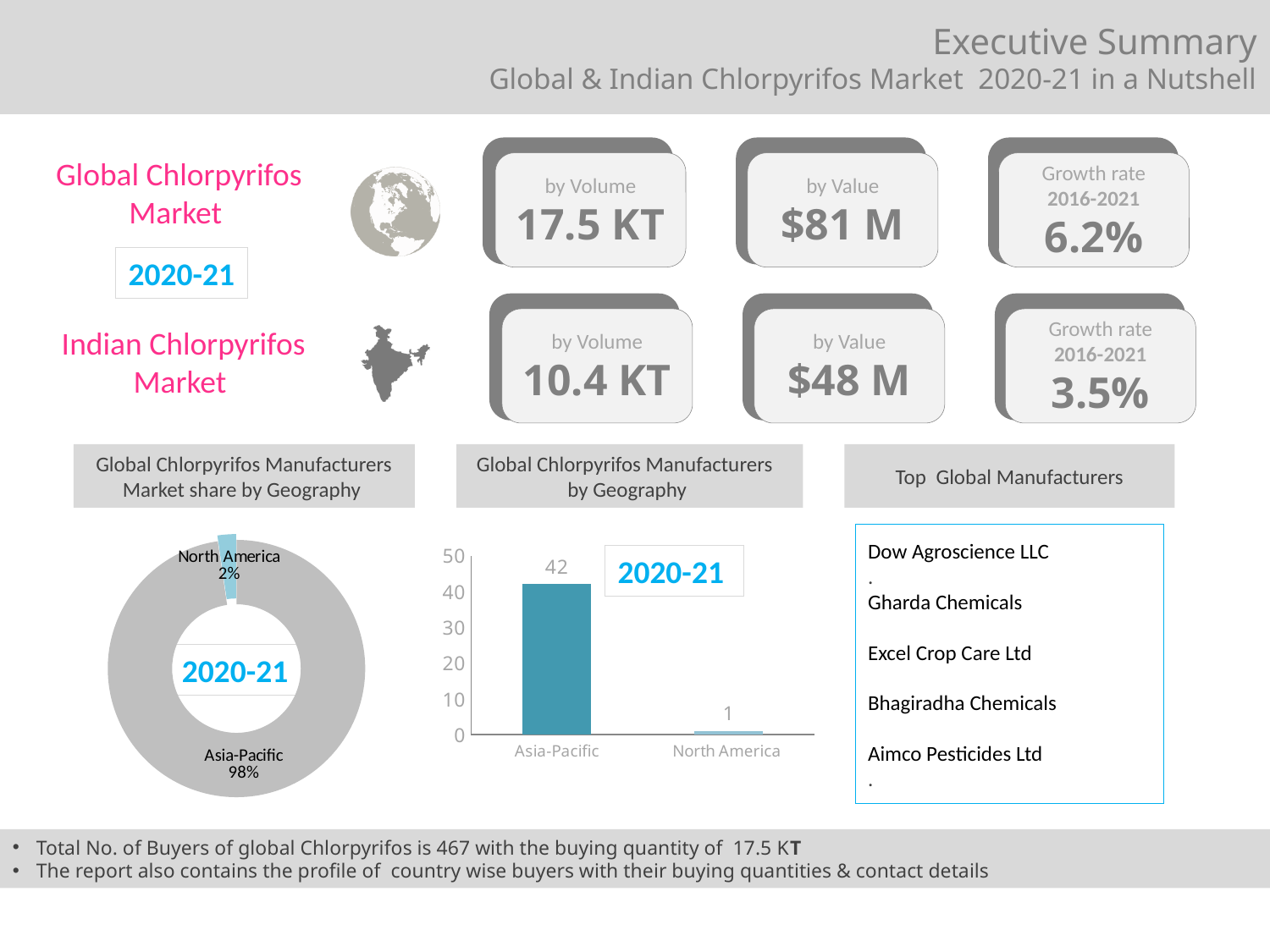
What kind of chart is the 'Global Chlorpyrifos Manufacturers Market share by Geography' chart? Doughnut chart In the 'Global Chlorpyrifos Manufacturers by Geography' bar chart, what is the value for North America? 1 In the 'Global Chlorpyrifos Manufacturers by Geography' bar chart, what is the value for Asia-Pacific? 42 In the 'Global Chlorpyrifos Manufacturers Market share by Geography' chart, which region has the larger share, Asia-Pacific or North America? Asia-Pacific How many categories are shown in the 'Global Chlorpyrifos Manufacturers by Geography' bar chart? 2 In the 'Global Chlorpyrifos Manufacturers Market share by Geography' chart, what share does North America hold? 2% What kind of chart is the 'Global Chlorpyrifos Manufacturers by Geography' chart? Bar chart In the 'Global Chlorpyrifos Manufacturers Market share by Geography' chart, what share does Asia-Pacific hold? 98% In the 'Global Chlorpyrifos Manufacturers by Geography' bar chart, what is the difference between the Asia-Pacific and North America values? 41 In the 'Global Chlorpyrifos Manufacturers by Geography' bar chart, is the value for Asia-Pacific greater or less than 40? greater In the 'Global Chlorpyrifos Manufacturers by Geography' bar chart, which region has the lowest value? North America In the 'Global Chlorpyrifos Manufacturers by Geography' bar chart, which region has the highest value? Asia-Pacific